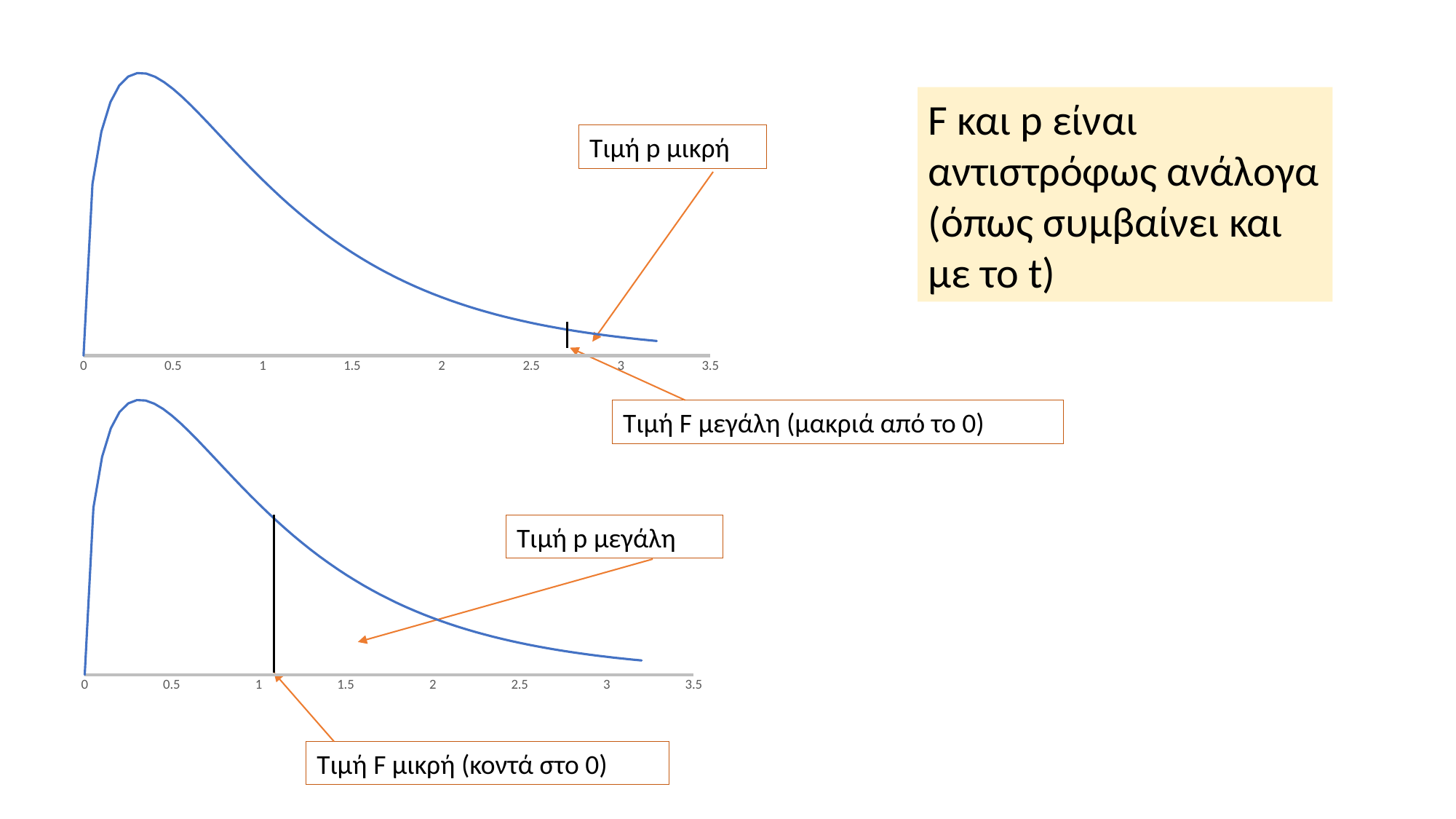
In the bottom chart, is the x position of the black vertical marker line greater or less than 1.5? less In the top chart, what is the largest value shown on the x axis? 3.5 What colour is the curve plotted in both charts? blue How many charts are shown on the slide? 2 What kind of chart is the top chart on the slide? line chart In the top chart, is the x position of the black vertical marker line greater or less than 2.5? greater In the top chart, is the x position of the black vertical marker line greater or less than 3? less In the bottom chart, does the curve rise or fall along the x axis between 1 and 3? fall In the top chart, does the curve rise or fall along the x axis after its peak near 0.3? fall Which chart has its black vertical marker line farther from 0 on the x axis, the top chart or the bottom chart? the top chart What kind of chart is the bottom chart on the slide? line chart